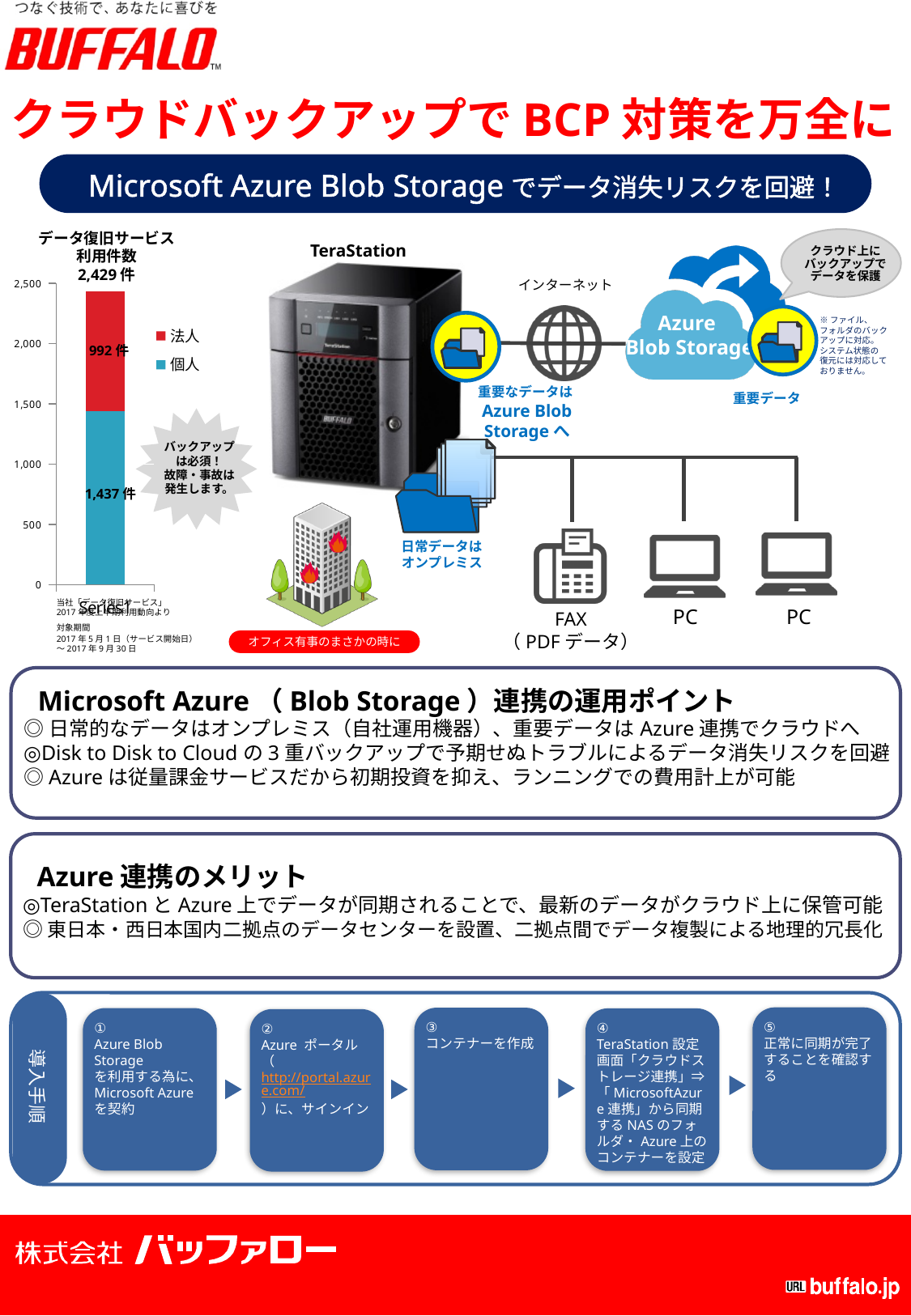
What kind of chart is shown on the left of the slide? bar chart What is the total of the stacked bar in the chart? 2,429 件 Is the value for 個人 in the bar chart greater or less than 1,000? greater What are the two legend entries of the bar chart? 法人, 個人 Is the value for 法人 in the bar chart greater or less than 1,000? less What is the value labelled for 個人 in the bar chart? 1,437 件 What is the value labelled for 法人 in the bar chart? 992 件 Which colour represents 法人 in the bar chart? red Which series has the larger value in the bar chart, 法人 or 個人? 個人 How many bars are plotted in the bar chart? 1 What is the difference between the 個人 value and the 法人 value in the bar chart? 445 件 How many series does the legend of the bar chart list? 2